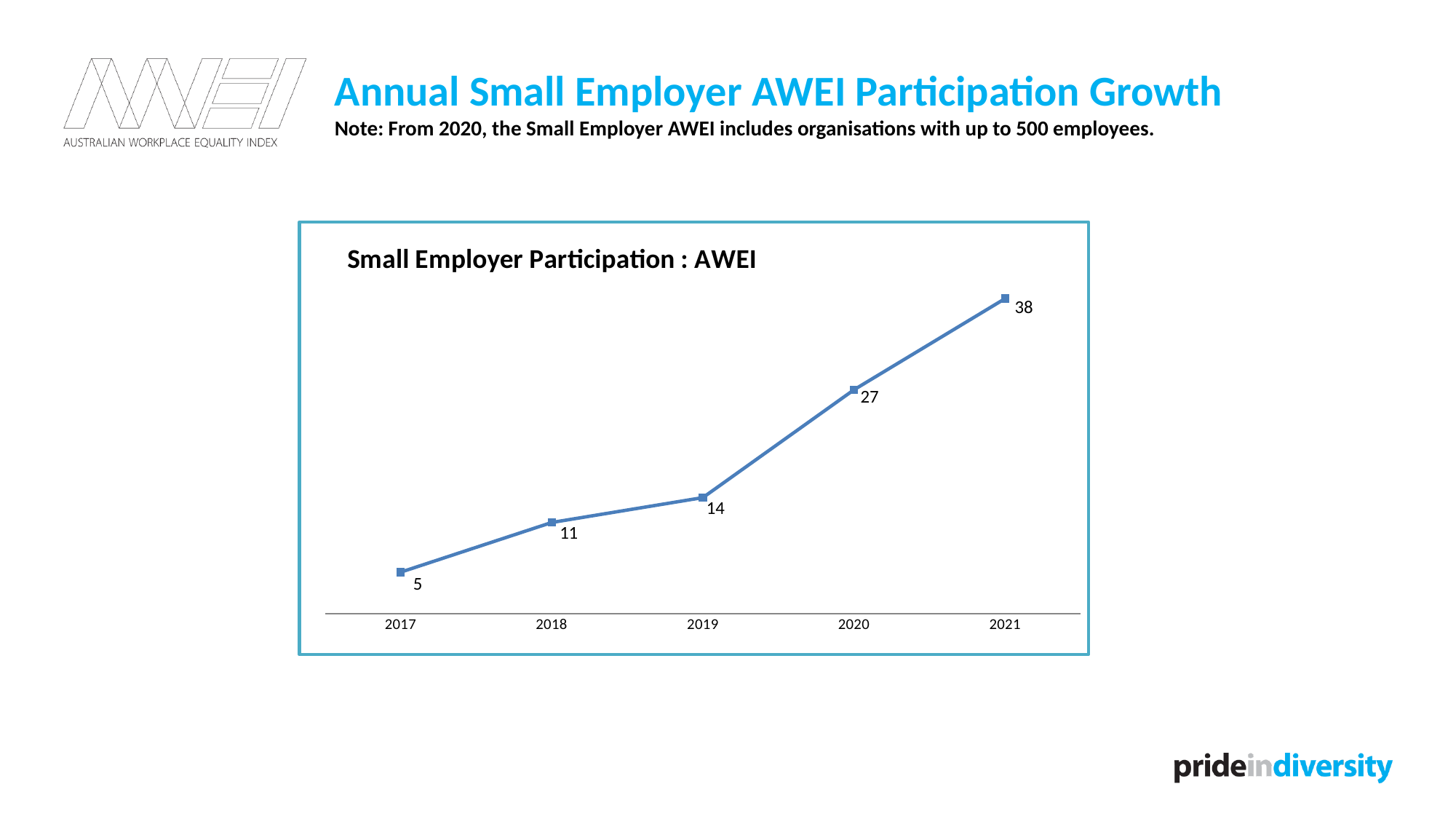
What kind of chart is shown? line chart What is the value for 2017? 5 What is the difference between the values for 2020 and 2019? 13 What is the title of the chart? Small Employer Participation : AWEI What is the value for 2019? 14 How many years are plotted on the chart? 5 Which is larger, the value for 2018 or the value for 2020? 2020 What is the value for 2021? 38 What is the difference between the values for 2021 and 2017? 33 Do the values rise or fall from 2017 to 2021? rise Which year has the lowest value? 2017 Which year has the highest value? 2021